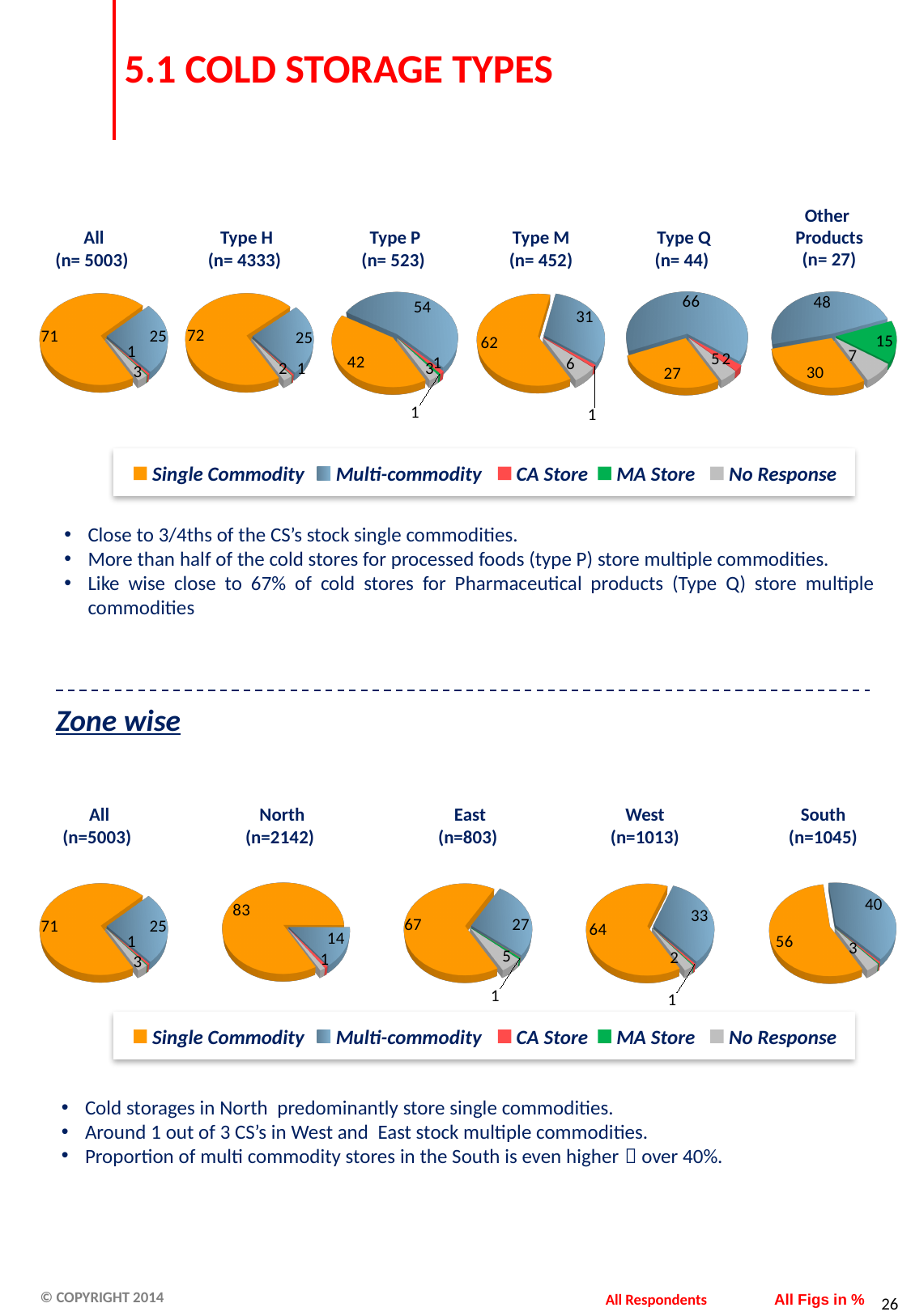
In the Zone wise row, what is the Multi-commodity share for South (n=1045)? 40 In the Zone wise row, which zone has the highest Multi-commodity share? South In the top row, what is the Multi-commodity share for Type P (n= 523)? 54 In the Zone wise row, what is the Single Commodity share for North (n=2142)? 83 In the Zone wise row, which is larger: the Multi-commodity share for West or for East? West In the Zone wise row, which zone has the lowest Single Commodity share? South In the top row, what is the Multi-commodity share for Type Q (n= 44)? 66 In the top row, what is the MA Store share for Other Products (n= 27)? 15 How many series does the legend list? 5 In the top row, what is the difference between the Single Commodity share for Type M (n= 452) and Type P (n= 523)? 20 In the top row, what is the Single Commodity share for Type H (n= 4333)? 72 What kind of chart is used on this slide? Pie chart